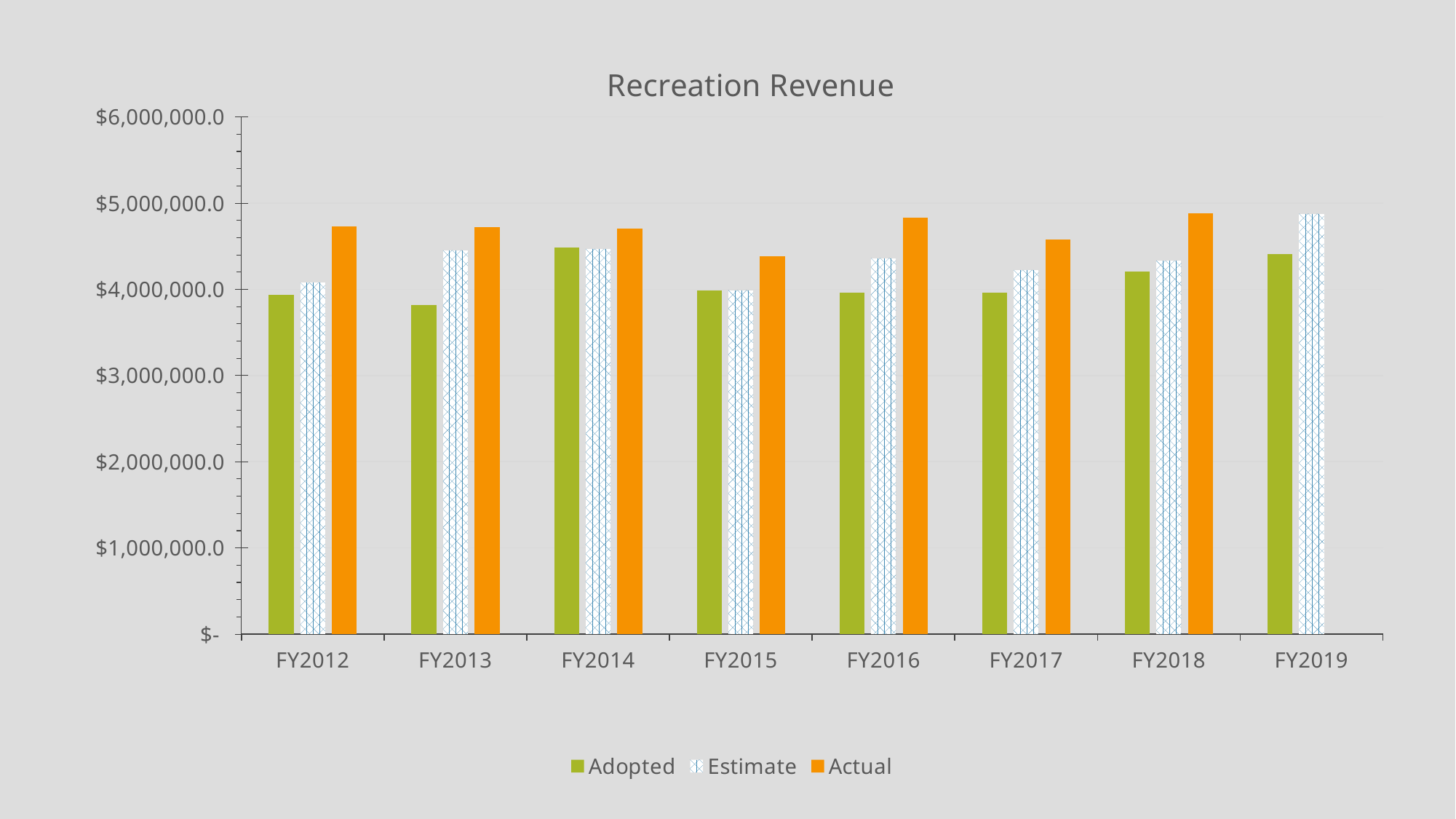
Is the Actual value for FY2016 greater or less than $4,000,000.0? greater Is the Adopted value for FY2014 greater or less than $4,000,000.0? greater What kind of chart is shown on the slide? bar chart Is the Adopted value for FY2013 greater or less than $4,000,000.0? less For FY2013, which is larger, the Adopted value or the Actual value? Actual How many series does the legend list? 3 For FY2017, which is larger, the Adopted value or the Estimate value? Estimate How many fiscal years are shown on the x axis? 8 What is the title of the chart? Recreation Revenue Which series has no bar for FY2019? Actual Which is larger, the Actual value for FY2012 or the Actual value for FY2015? FY2012